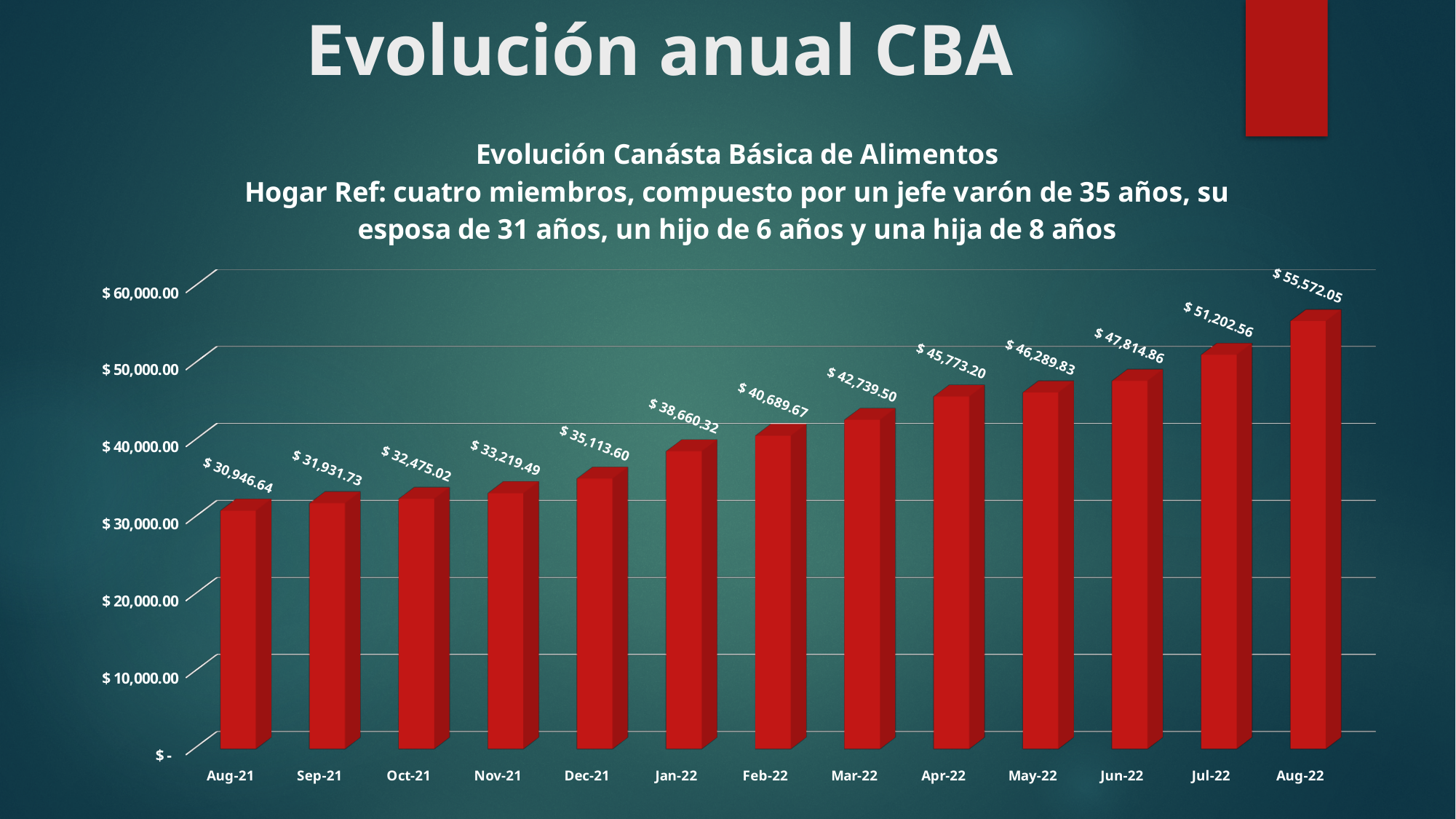
Which month has the highest value? Aug-22 Do the values rise or fall from Aug-21 to Aug-22? rise Which month has the lowest value? Aug-21 Which is larger, the value for Feb-22 or the value for Mar-22? Mar-22 Is the value for Dec-21 greater or less than 40,000? less What kind of chart is shown on the slide? bar chart What is the difference between the values for Jul-22 and Jun-22? $ 3,387.70 What is the difference between the values for Aug-22 and Aug-21? $ 24,625.41 How many months are shown on the x axis? 13 What is the value for Mar-22? $ 42,739.50 What is the value for Aug-21? $ 30,946.64 What is the value for Jun-22? $ 47,814.86